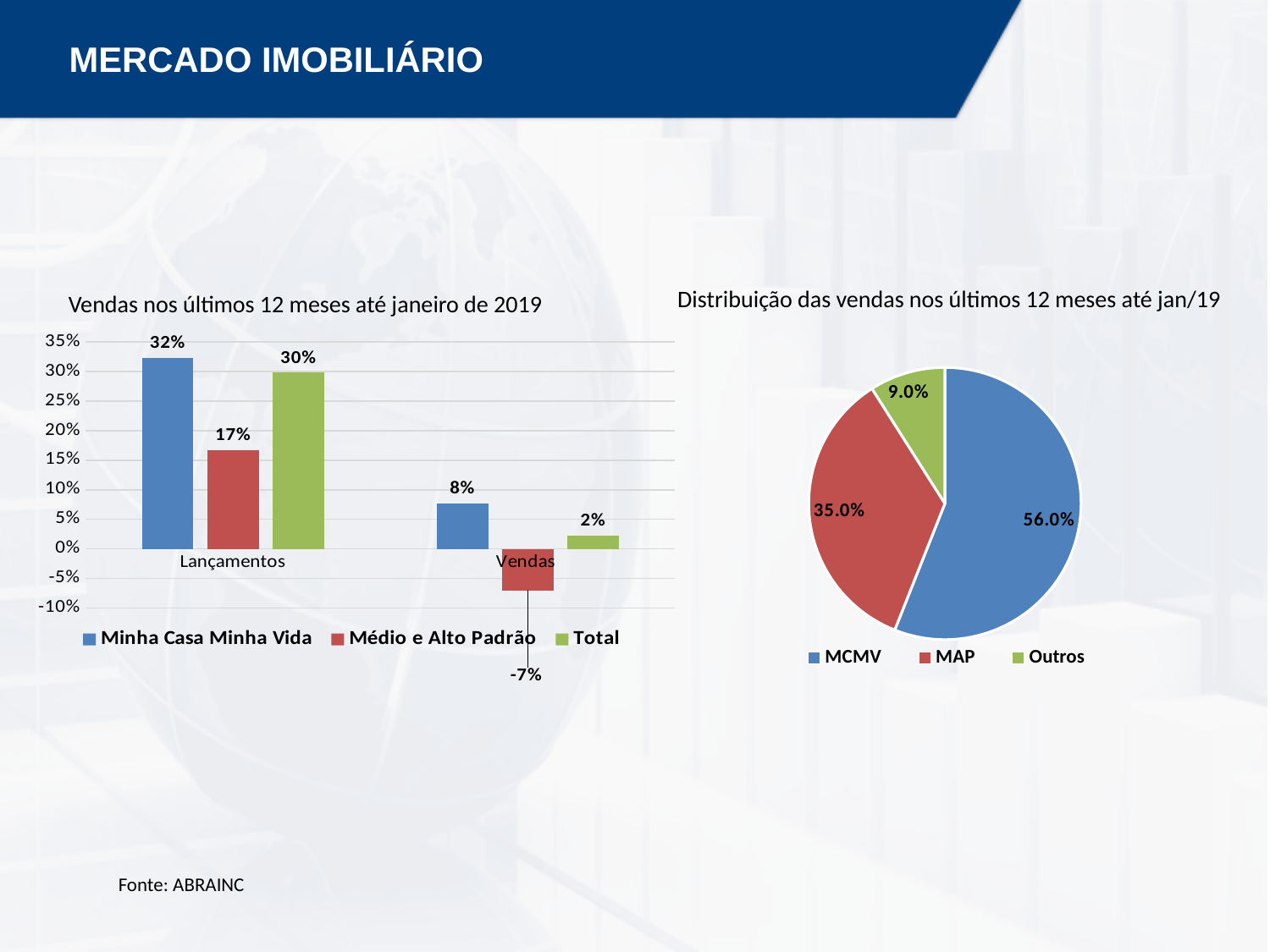
In the chart 'Vendas nos últimos 12 meses até janeiro de 2019', what is the Total value for Vendas? 2% In the pie chart 'Distribuição das vendas nos últimos 12 meses até jan/19', which slice is the largest? MCMV What kind of chart is 'Vendas nos últimos 12 meses até janeiro de 2019'? Bar chart How many slices does the pie chart 'Distribuição das vendas nos últimos 12 meses até jan/19' have? 3 In the chart 'Vendas nos últimos 12 meses até janeiro de 2019', is the Total value for Lançamentos or for Vendas larger? Lançamentos In the chart 'Vendas nos últimos 12 meses até janeiro de 2019', what is the difference between the Minha Casa Minha Vida value and the Médio e Alto Padrão value in Lançamentos? 15% In the chart 'Vendas nos últimos 12 meses até janeiro de 2019', what is the value for Médio e Alto Padrão in Vendas? -7% In the pie chart 'Distribuição das vendas nos últimos 12 meses até jan/19', what share does MAP have? 35.0% How many series does the legend of the chart 'Vendas nos últimos 12 meses até janeiro de 2019' list? 3 In the chart 'Vendas nos últimos 12 meses até janeiro de 2019', which series has the lowest value in Vendas? Médio e Alto Padrão In the chart 'Vendas nos últimos 12 meses até janeiro de 2019', which series has the highest value in Lançamentos? Minha Casa Minha Vida In the chart 'Vendas nos últimos 12 meses até janeiro de 2019', what is the value for Minha Casa Minha Vida in Lançamentos? 32%